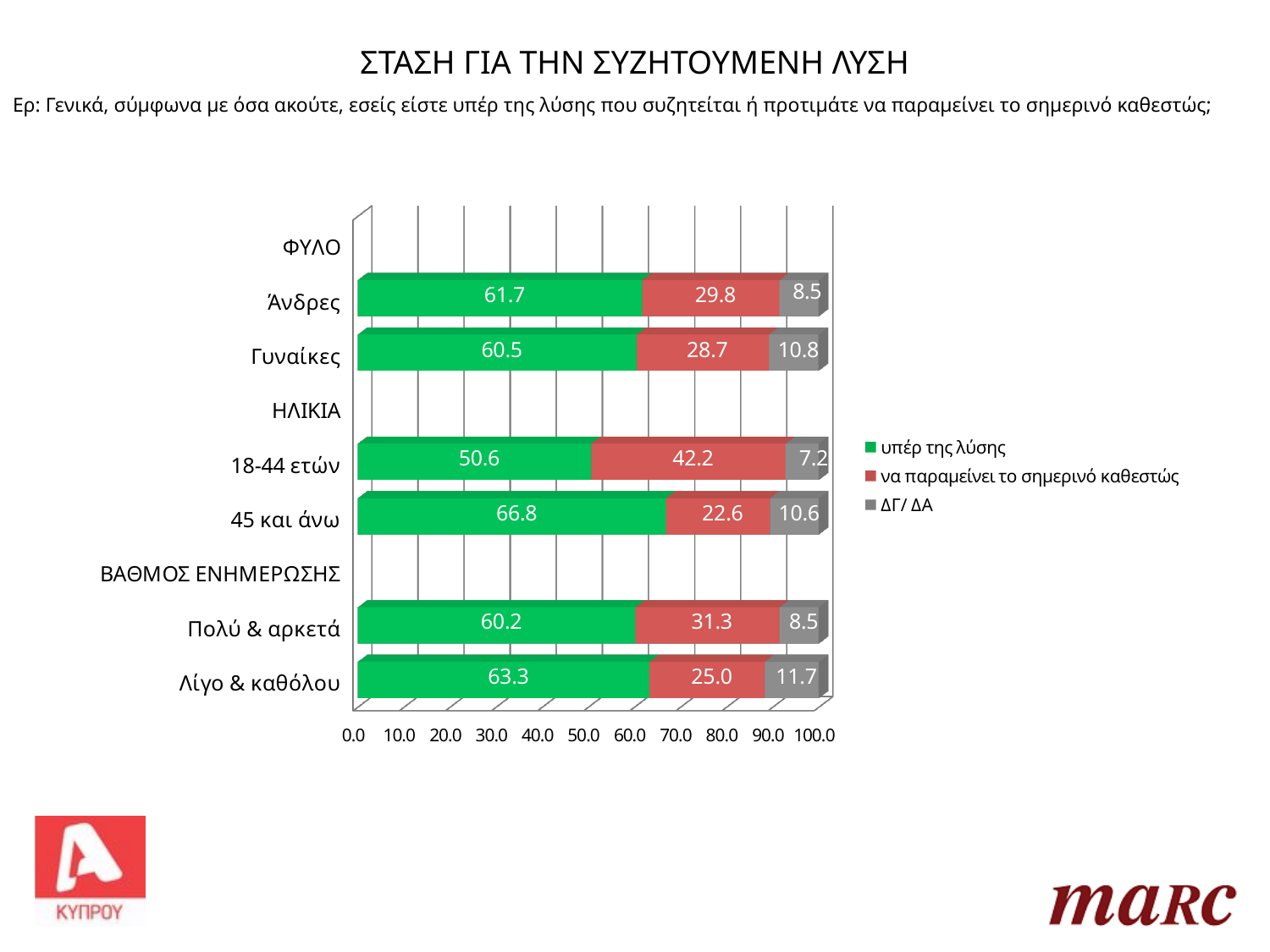
What kind of chart is shown on the slide? Stacked bar chart How many series does the legend list? 3 Which category has the lowest value for 'υπέρ της λύσης'? 18-44 ετών What is the total of the stacked bar for 'Γυναίκες'? 100.0 What is the value of 'ΔΓ/ ΔΑ' for 'Λίγο & καθόλου'? 11.7 What is the difference between the 'υπέρ της λύσης' values for '45 και άνω' and '18-44 ετών'? 16.2 What is the value of 'να παραμείνει το σημερινό καθεστώς' for '18-44 ετών'? 42.2 Which category has the highest value for 'υπέρ της λύσης'? 45 και άνω What is the value of 'υπέρ της λύσης' for 'Άνδρες'? 61.7 Which is larger: the 'να παραμείνει το σημερινό καθεστώς' value for 'Πολύ & αρκετά' or for 'Λίγο & καθόλου'? Πολύ & αρκετά How many categories have data bars plotted in the chart? 6 Which category has the lowest value for 'ΔΓ/ ΔΑ'? 18-44 ετών